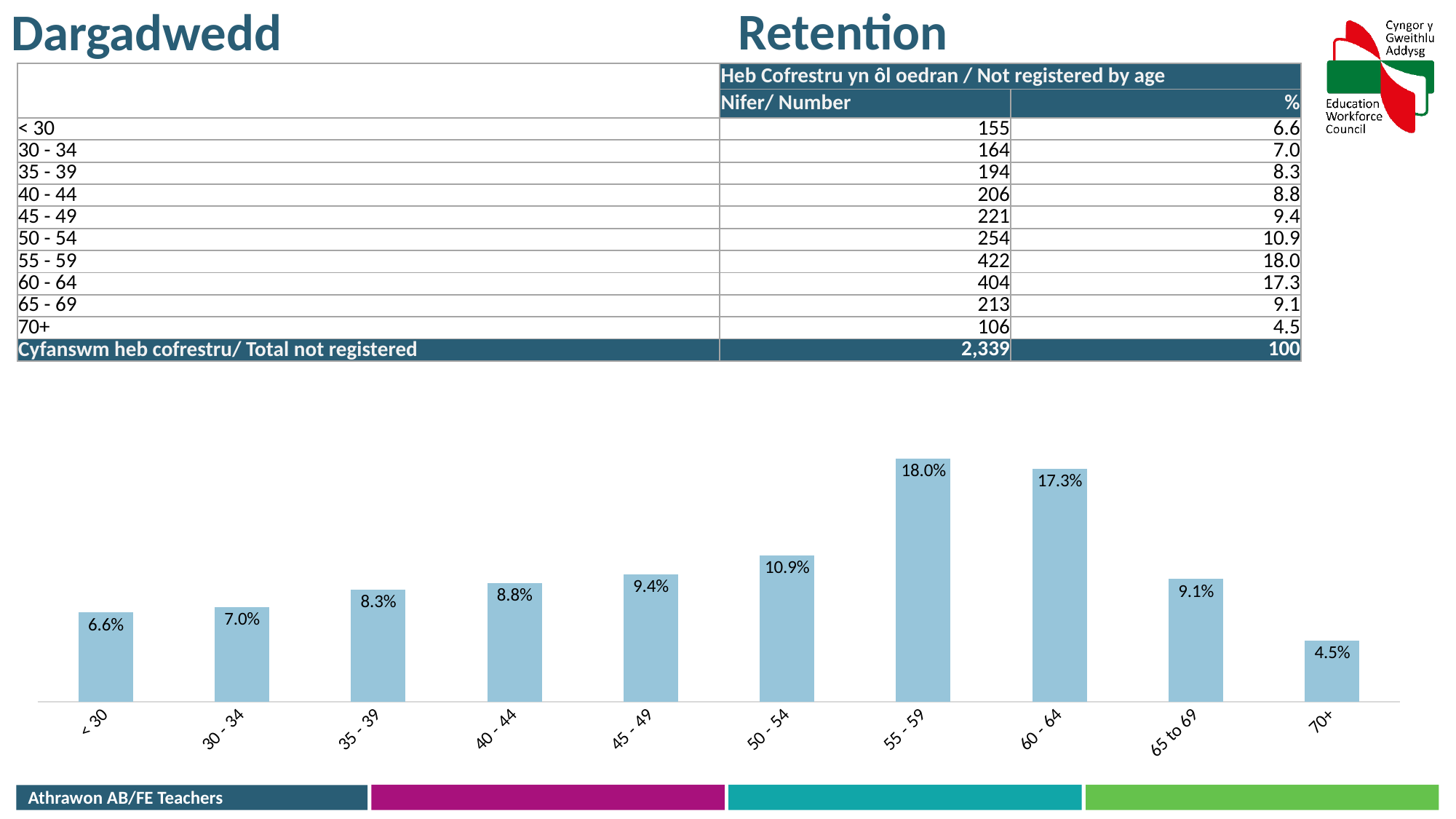
How many age groups are plotted in the bar chart? 10 What is the value shown for the < 30 age group in the bar chart? 6.6% Do the bar values rise or fall from < 30 to 55 - 59 along the x axis? rise Which is larger in the bar chart, the value for 40 - 44 or the value for 65 to 69? 65 to 69 What is the difference between the values for 55 - 59 and 60 - 64 in the bar chart? 0.7% Which age group has the lowest bar in the chart? 70+ What is the value shown for the 65 to 69 age group in the bar chart? 9.1% Which age group has the highest bar in the chart? 55 - 59 What kind of chart is shown on the slide? bar chart What is the value shown for the 55 - 59 age group in the bar chart? 18.0% What is the difference between the values for 50 - 54 and 45 - 49 in the bar chart? 1.5% What colour are the bars in the chart? light blue